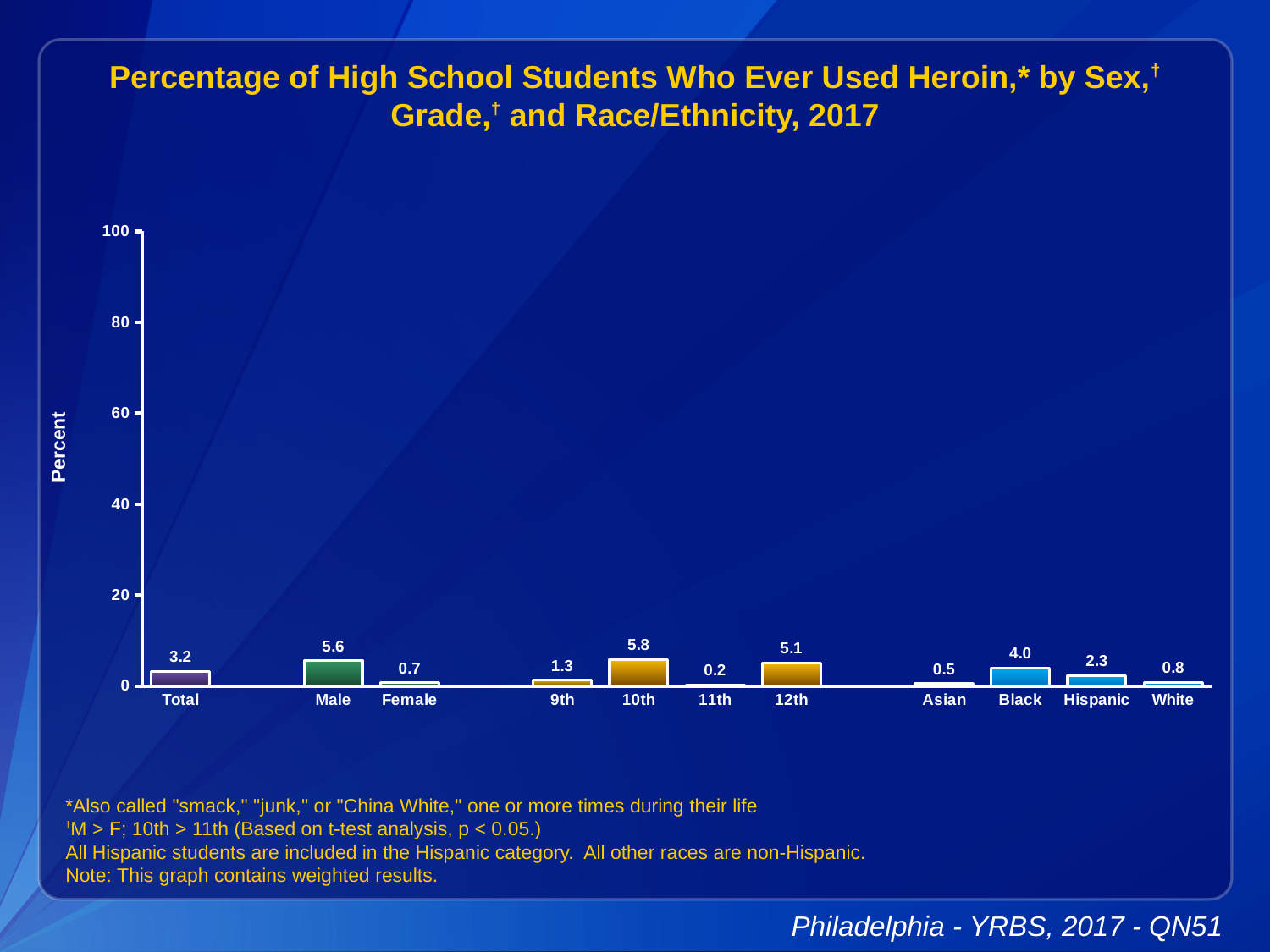
What is the value for Male? 5.6 What is the value for 11th grade? 0.2 What is the value for Hispanic students? 2.3 Which category has the lowest value? 11th Which category has the highest value? 10th What is the value for Total? 3.2 What is the difference between the values for Male and Female? 4.9 Which is larger, the value for Black or the value for White? Black What is the label of the y axis? Percent What kind of chart is this? Bar chart How many categories are shown on the x axis? 11 What is the difference between the values for 10th and 11th grade? 5.6